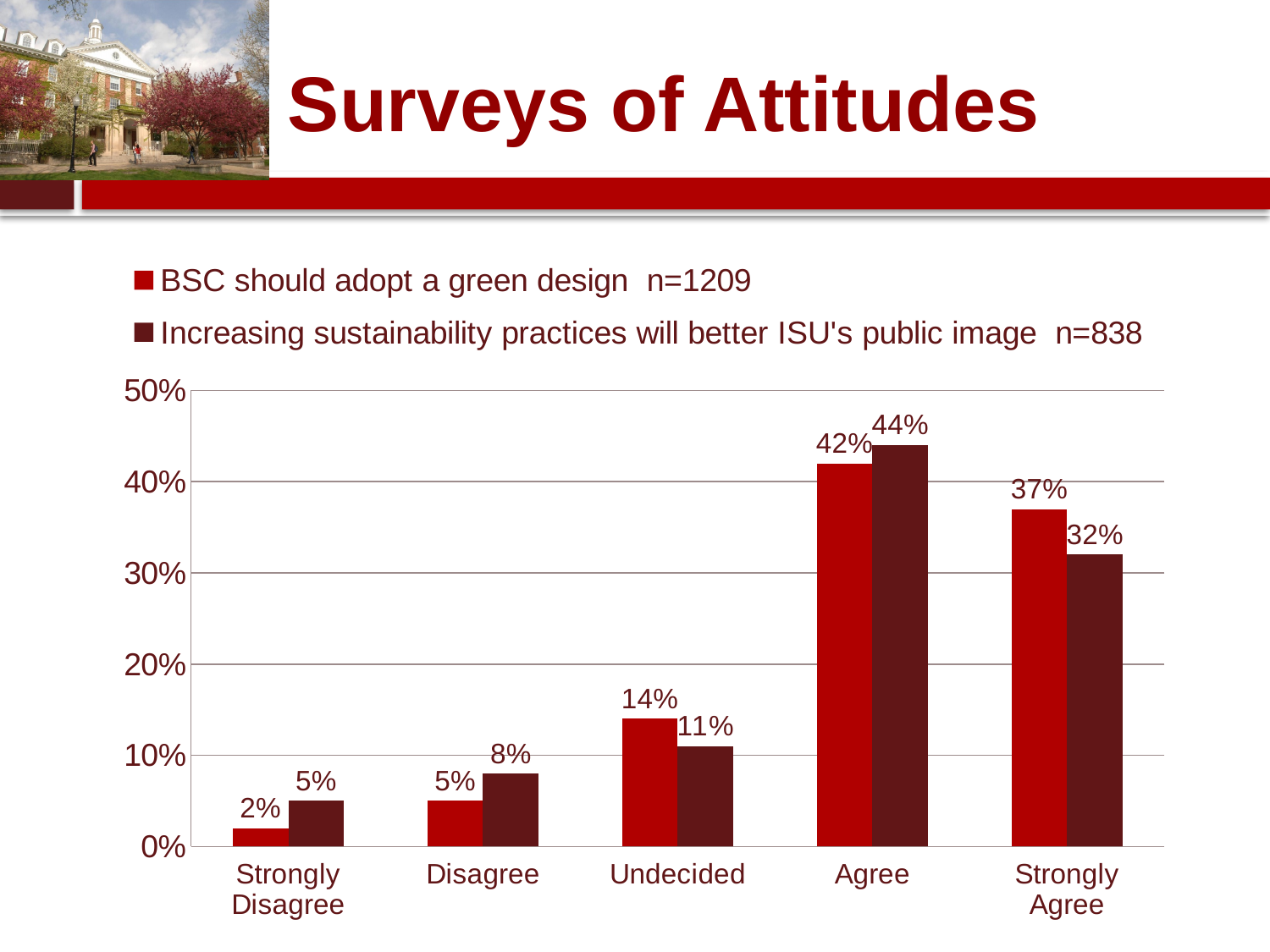
What percentage of respondents chose Strongly Agree for 'Increasing sustainability practices will better ISU's public image'? 32% How many series does the legend list? 2 For Disagree, which series has the larger value? Increasing sustainability practices will better ISU's public image What is the sample size (n) for the 'BSC should adopt a green design' series? n=1209 What is the difference between the two series' values for Strongly Agree? 5% What kind of chart is shown on the slide? Bar chart Which response category has the lowest value for 'BSC should adopt a green design'? Strongly Disagree Which response category has the highest value for 'Increasing sustainability practices will better ISU's public image'? Agree Is the value for Agree in the 'BSC should adopt a green design' series greater or less than 40%? greater What is the value for Undecided in the 'BSC should adopt a green design' series? 14% What percentage of respondents chose Agree for 'BSC should adopt a green design'? 42% How many response categories are shown on the x axis? 5